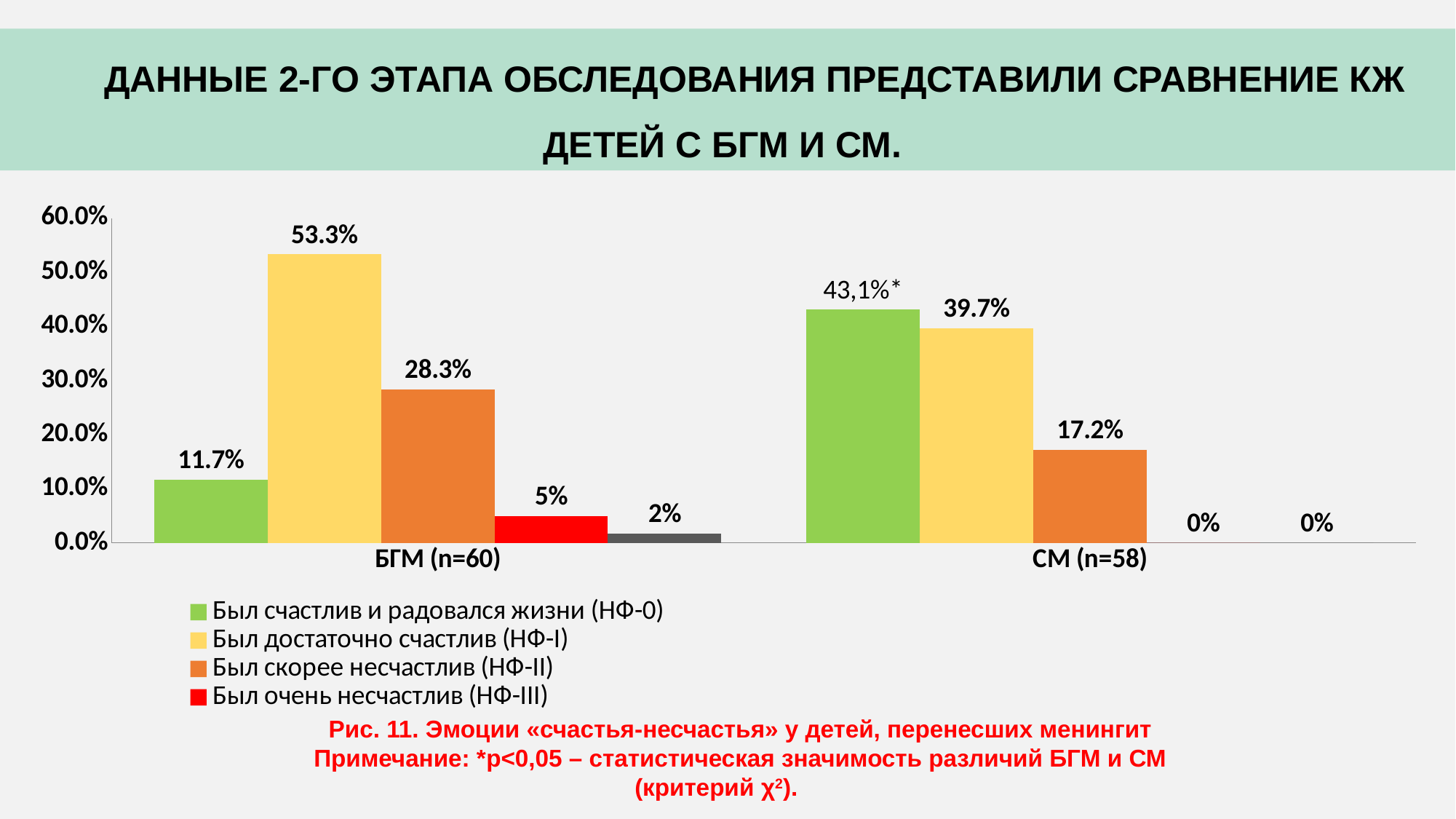
Which group has the larger value for 'Был скорее несчастлив (НФ-II)': БГМ (n=60) or СМ (n=58)? БГМ (n=60) Which series has the highest value in the СМ (n=58) group? Был счастлив и радовался жизни (НФ-0) What type of chart is shown on the slide? bar chart What is the difference between the 'Был достаточно счастлив (НФ-I)' values for БГМ (n=60) and СМ (n=58)? 13.6% How many series does the legend list? 4 How many groups (categories) are shown on the x axis? 2 Which series has the highest value in the БГМ (n=60) group? Был достаточно счастлив (НФ-I) What is the value for 'Был очень несчастлив (НФ-III)' in the СМ (n=58) group? 0% What is the value for 'Был скорее несчастлив (НФ-II)' in the СМ (n=58) group? 17.2% What is the value for 'Был очень несчастлив (НФ-III)' in the БГМ (n=60) group? 5% What is the value for 'Был счастлив и радовался жизни (НФ-0)' in the БГМ (n=60) group? 11.7% What is the value for 'Был достаточно счастлив (НФ-I)' in the БГМ (n=60) group? 53.3%